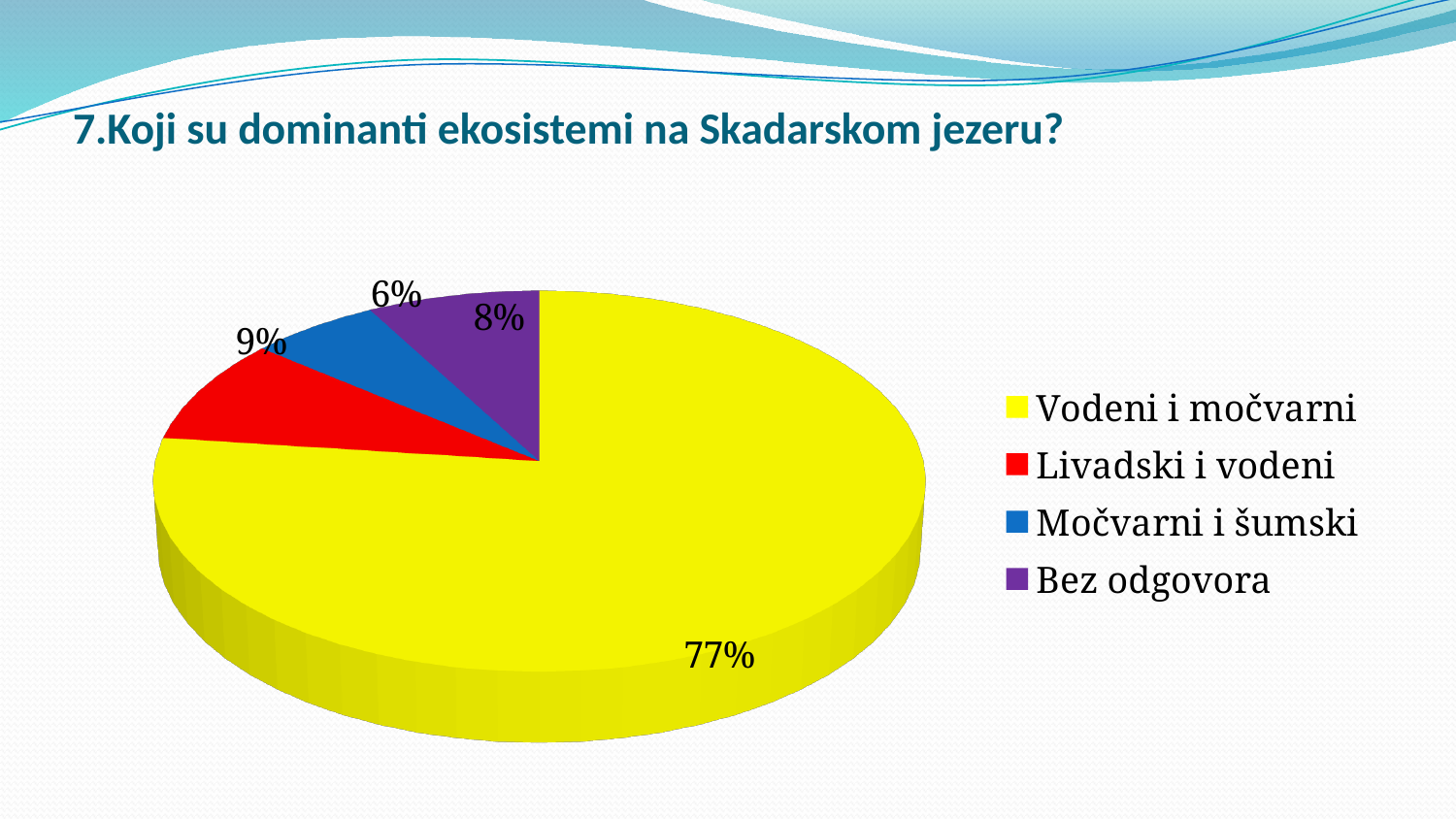
Which is larger, the share for "Bez odgovora" or the share for "Močvarni i šumski"? Bez odgovora What is the difference in percentage points between "Vodeni i močvarni" and "Livadski i vodeni"? 68 What share of the pie does "Močvarni i šumski" have? 6% What kind of chart is shown on the slide? pie chart What is the title of the slide above the chart? 7.Koji su dominanti ekosistemi na Skadarskom jezeru? Which category has the largest slice of the pie? Vodeni i močvarni What share of the pie does "Livadski i vodeni" have? 9% What share of the pie does "Bez odgovora" have? 8% How many categories does the pie chart show? 4 What colour is the slice for "Livadski i vodeni"? red Which category has the smallest slice of the pie? Močvarni i šumski